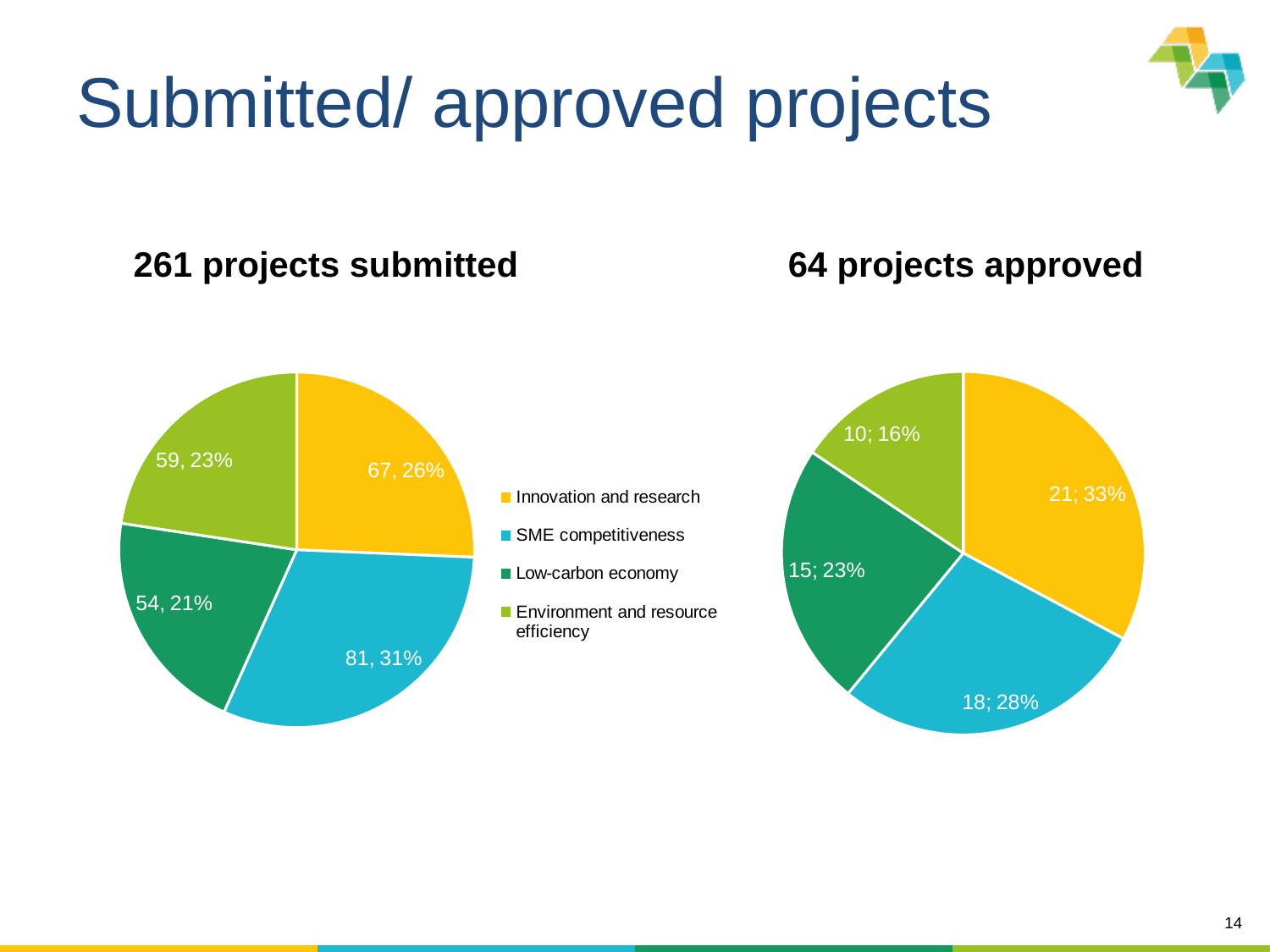
In the '261 projects submitted' pie chart, how many projects were submitted for SME competitiveness? 81 In the '261 projects submitted' pie chart, how many projects were submitted for Environment and resource efficiency? 59 What type of chart is used for the '64 projects approved' data? Pie chart In the '64 projects approved' pie chart, what share of the pie does SME competitiveness represent? 28% In the '64 projects approved' pie chart, which is larger: Innovation and research or Environment and resource efficiency? Innovation and research In the '261 projects submitted' pie chart, what is the difference between the number of Innovation and research projects and Low-carbon economy projects? 13 Which colour represents Low-carbon economy in the legend? Dark green In the '261 projects submitted' pie chart, what share of the pie does Innovation and research represent? 26% In the '64 projects approved' pie chart, which category has the smallest slice? Environment and resource efficiency How many categories does the '261 projects submitted' pie chart show? 4 In the '64 projects approved' pie chart, how many projects were approved for Low-carbon economy? 15 In the '261 projects submitted' pie chart, which category has the largest slice? SME competitiveness